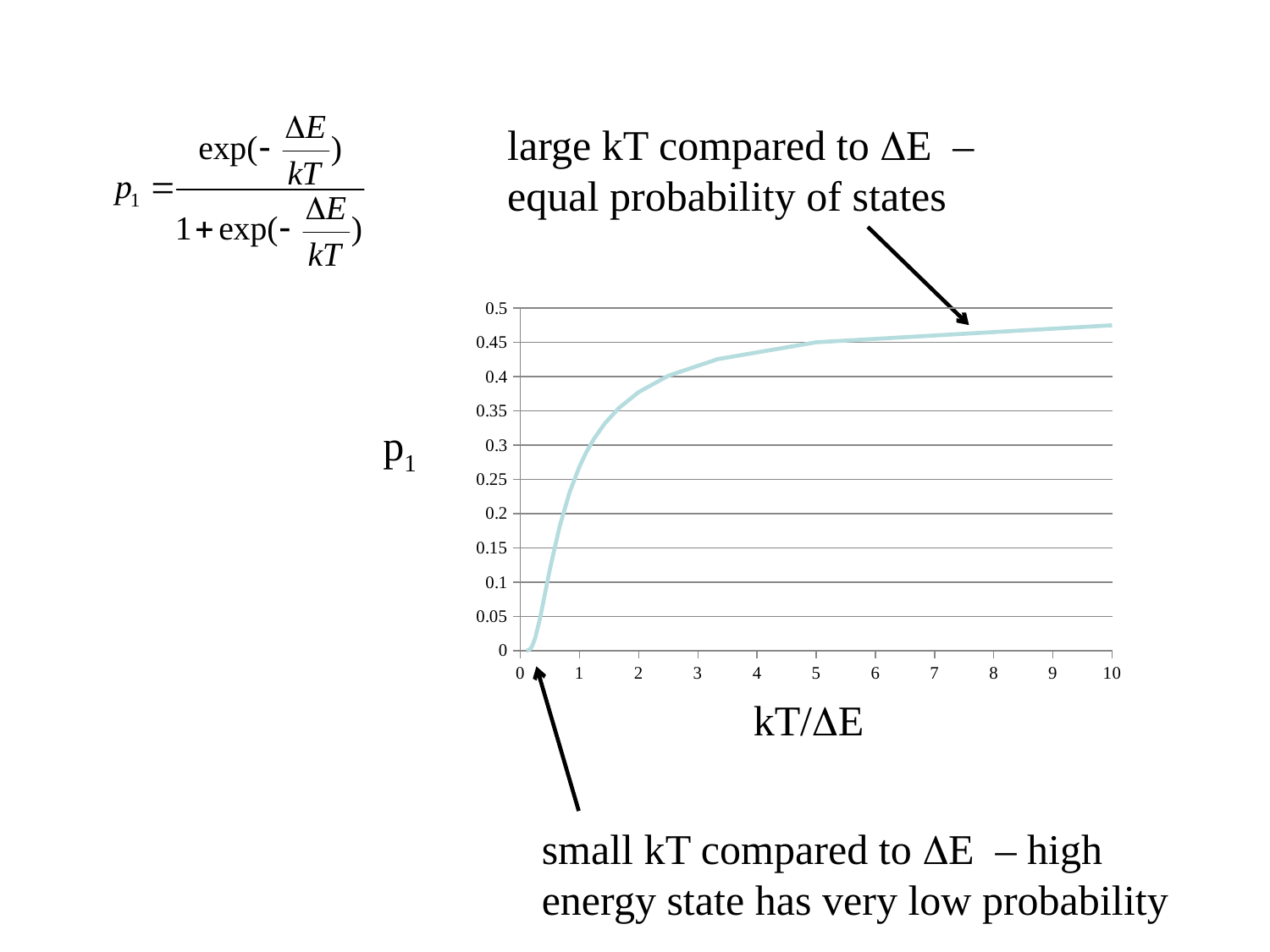
What kind of chart is shown on the slide? line chart Does the plotted value of p1 rise or fall as kT/ΔE increases? rise How many lines are plotted on the chart? 1 Is the value of p1 at kT/ΔE = 0.5 greater or less than 0.25? less Is the value of p1 at kT/ΔE = 10 greater or less than 0.45? greater What is the label of the y axis of the chart? p1 What is the highest value shown on the y axis of the chart? 0.5 Is the value of p1 at kT/ΔE = 1 greater or less than 0.3? less What is the label of the x axis of the chart? kT/ΔE Which is larger, the value of p1 at kT/ΔE = 1 or at kT/ΔE = 5? kT/ΔE = 5